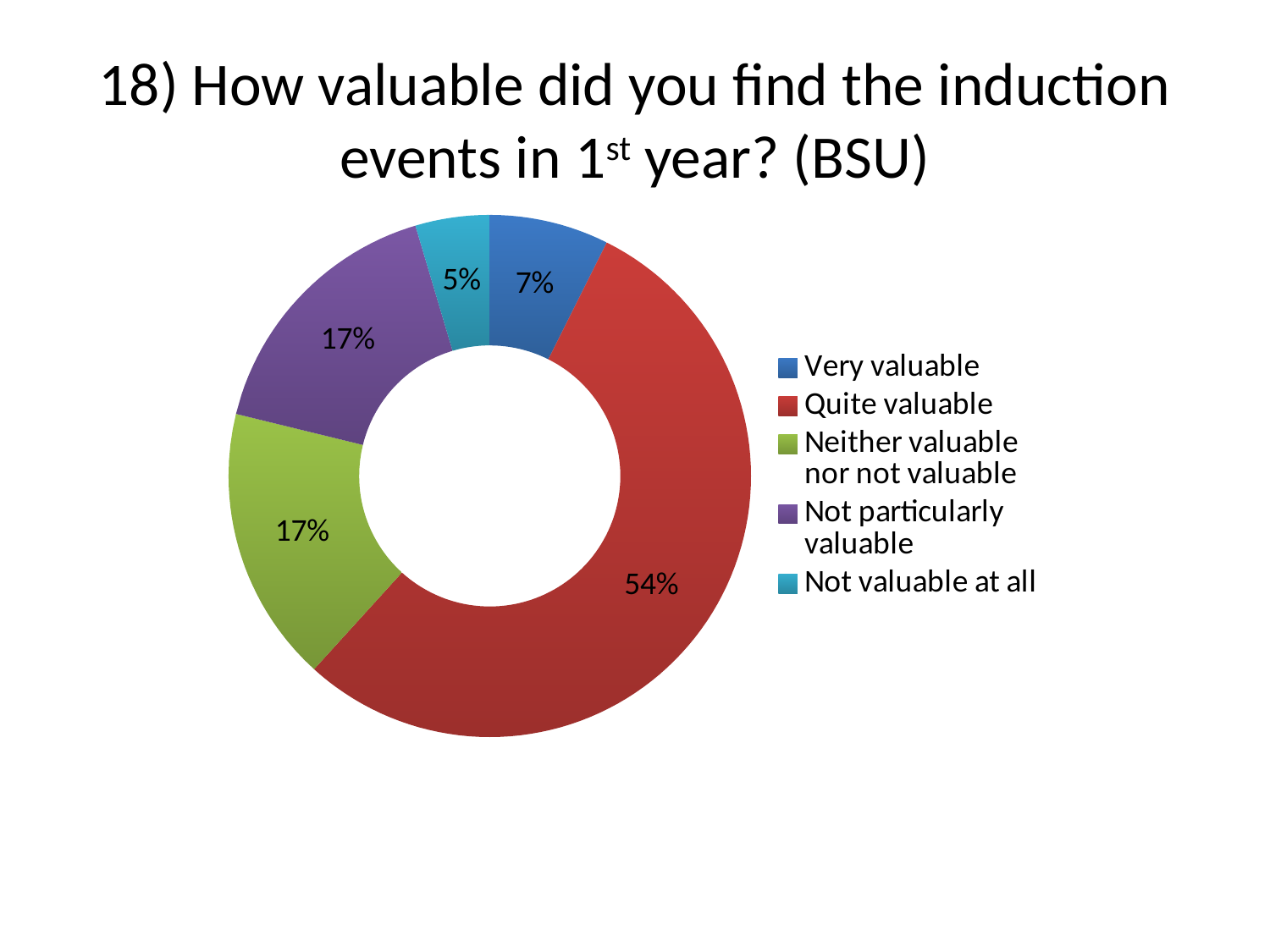
What percentage of respondents found the induction events 'Quite valuable'? 54% What percentage of respondents answered 'Not particularly valuable'? 17% What kind of chart is shown on the slide? Doughnut (pie) chart What is the combined share of 'Neither valuable nor not valuable' and 'Not particularly valuable'? 34% Which response category has the largest share of the chart? Quite valuable Which is larger: the share for 'Very valuable' or the share for 'Not valuable at all'? Very valuable How many response categories are shown in the chart? 5 What percentage of respondents found the induction events 'Not valuable at all'? 5% Which colour represents 'Quite valuable' in the chart? Red Which response category has the smallest share of the chart? Not valuable at all What is the difference in percentage points between 'Quite valuable' and 'Very valuable'? 47 What percentage of respondents found the induction events 'Very valuable'? 7%